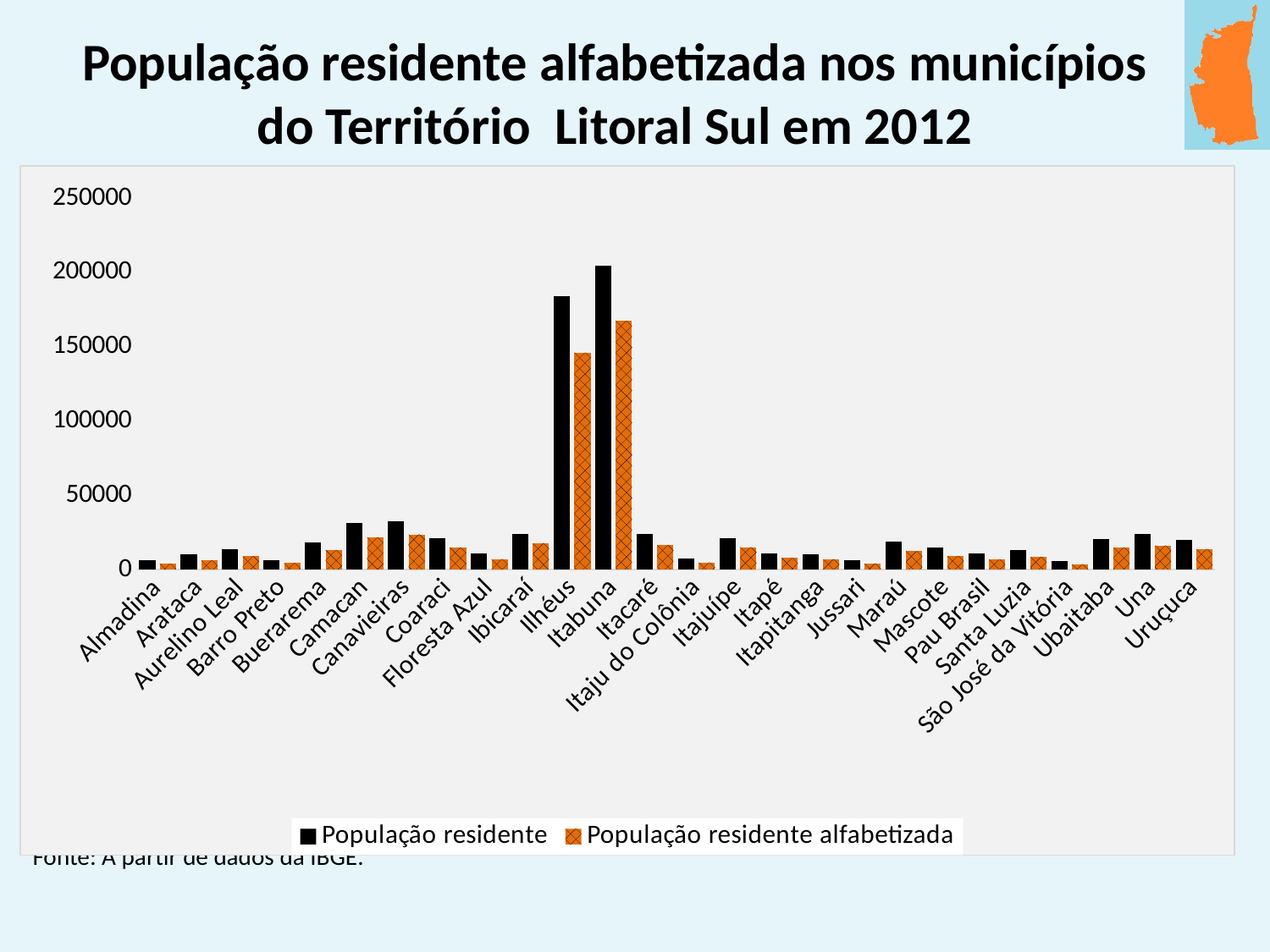
Is the População residente for Ilhéus greater or less than 200000? less How many municipalities are shown on the x axis? 26 Which is larger, the População residente of Camacan or of Almadina? Camacan Is the População residente for Ilhéus greater or less than 150000? greater What are the two series named in the legend? População residente and População residente alfabetizada Is the População residente alfabetizada for Itabuna greater or less than 150000? greater What is the title of the chart on the slide? População residente alfabetizada nos municípios do Território Litoral Sul em 2012 Which municipality has the highest População residente alfabetizada? Itabuna Which is larger, the População residente of Itabuna or of Ilhéus? Itabuna How many series does the legend list? 2 Which municipality has the highest População residente? Itabuna What kind of chart is shown on the slide? bar chart